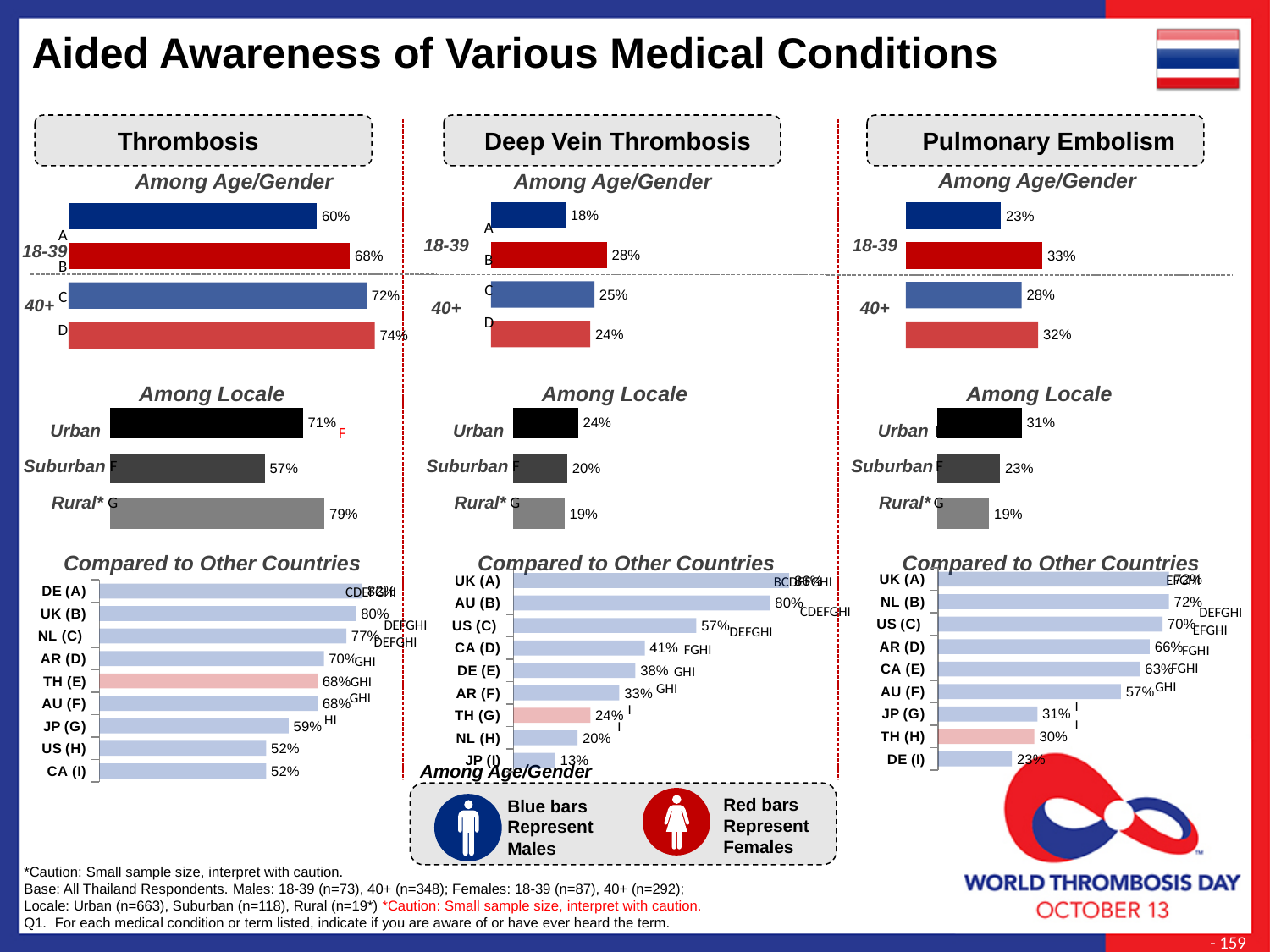
In the Thrombosis 'Compared to Other Countries' chart, what is the difference between UK (B) and US (H)? 28% In the Deep Vein Thrombosis 'Compared to Other Countries' chart, how many countries are listed? 9 In the Thrombosis 'Among Locale' chart, what is the value for Suburban? 57% In the Deep Vein Thrombosis 'Among Age/Gender' chart, what is the value for bar B? 28% In the Thrombosis 'Among Age/Gender' chart, what is the difference between bar D and bar A? 14% What type of chart is used in the Pulmonary Embolism 'Among Age/Gender' section? Bar chart In the Deep Vein Thrombosis 'Compared to Other Countries' chart, what is the value for JP (I)? 13% In the Thrombosis 'Among Locale' chart, which locale has the highest value? Rural* In the Pulmonary Embolism 'Compared to Other Countries' chart, what is the value for TH (H)? 30% In the Pulmonary Embolism 'Compared to Other Countries' chart, which is larger, AU (F) or JP (G)? AU (F) In the Pulmonary Embolism 'Among Locale' chart, what is the value for Urban? 31% In the Deep Vein Thrombosis 'Among Locale' chart, which locale has the lowest value? Rural*